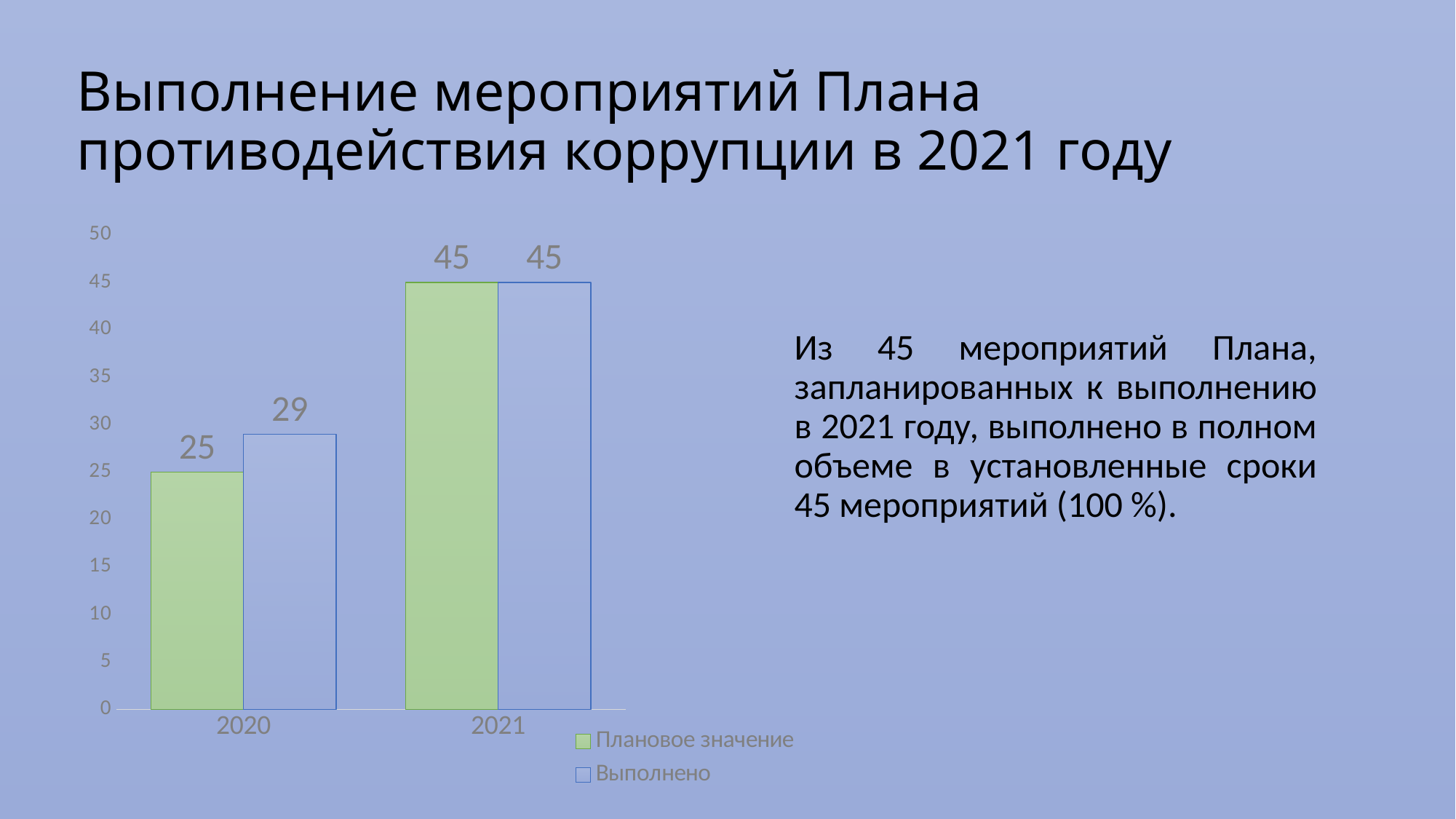
Which year has the lower value for "Плановое значение"? 2020 What is the value of "Выполнено" for 2021? 45 By how much did "Плановое значение" increase from 2020 to 2021? 20 How many years are shown on the x axis? 2 In 2020, which is larger: "Плановое значение" or "Выполнено"? Выполнено What is the value of "Плановое значение" for 2021? 45 What is the value of "Выполнено" for 2020? 29 How many series does the legend list? 2 What is the value of "Плановое значение" for 2020? 25 What kind of chart is shown on the slide? Bar chart What is the difference between "Выполнено" and "Плановое значение" in 2020? 4 Which year has the higher value for "Выполнено"? 2021